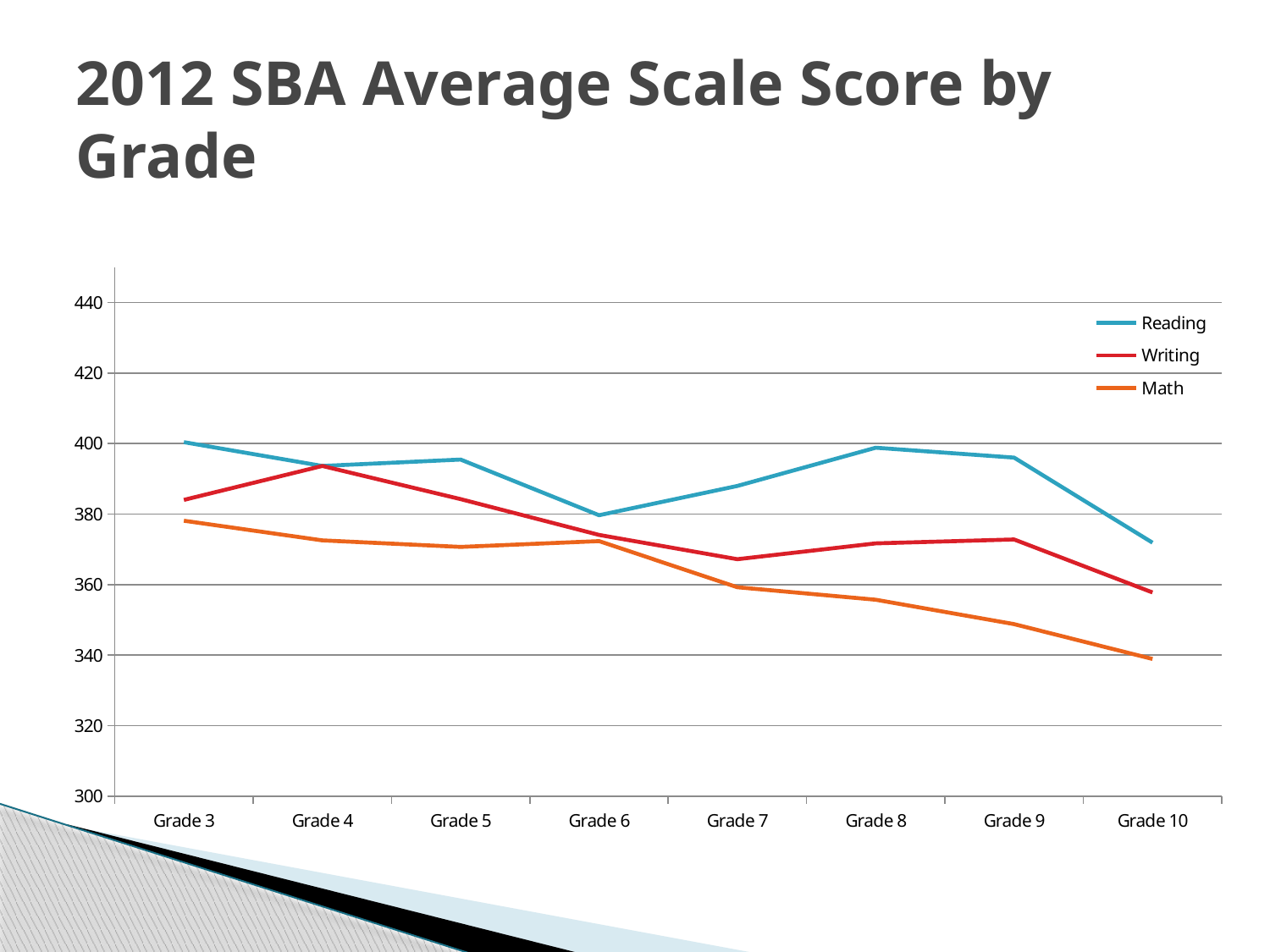
Is the Math score for Grade 8 greater or less than 360? less Is the Reading score for Grade 10 greater or less than 380? less Which grade has the lowest Math score? Grade 10 What kind of chart is shown on the slide? line chart At Grade 9, which is larger, the Writing score or the Math score? Writing Which grade has the highest Writing score? Grade 4 Which series is shown in orange in the legend? Math Which grade has the highest Math score? Grade 3 Which grade has the lowest Reading score? Grade 10 How many series does the legend list? 3 Do the Math scores generally rise or fall from Grade 3 to Grade 10? fall How many grade categories are shown on the x axis? 8